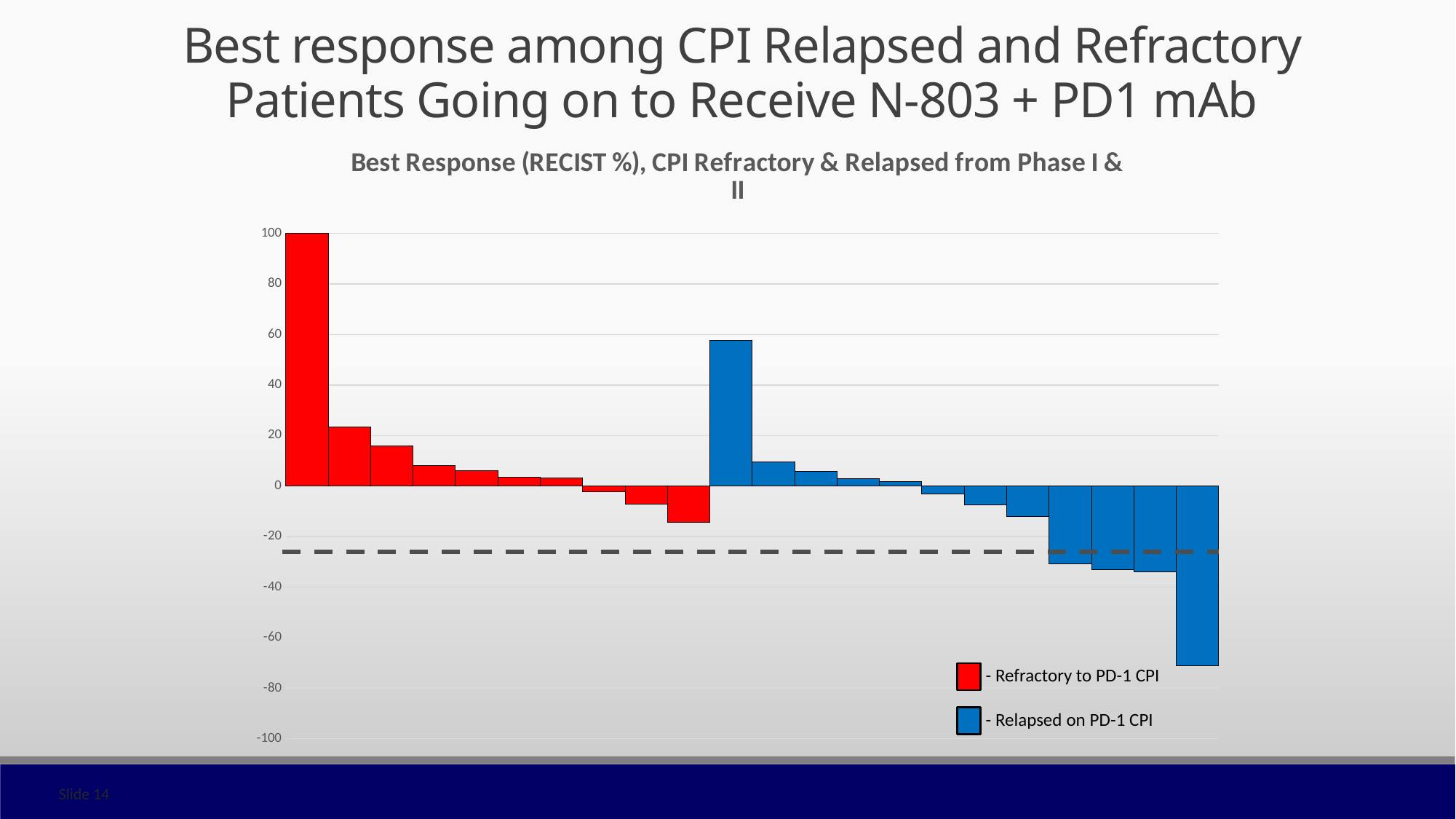
Which is larger: the tallest red bar or the tallest blue bar? The tallest red bar What are the two legend entries in the chart? Refractory to PD-1 CPI; Relapsed on PD-1 CPI How many series does the legend list? 2 Within each colour group, do the bar values rise or fall from left to right? Fall Is the value of the lowest blue (Relapsed on PD-1 CPI) bar greater or less than -60? less Is the value of the tallest blue (Relapsed on PD-1 CPI) bar greater or less than 40? greater Which series contains the single highest bar in the chart? Refractory to PD-1 CPI How many red (Refractory to PD-1 CPI) bars are plotted? 10 What kind of chart is shown on the slide? Bar chart Is the value of the tallest red (Refractory to PD-1 CPI) bar greater or less than 80? greater Which series contains the single lowest bar in the chart? Relapsed on PD-1 CPI What colour represents patients refractory to PD-1 CPI? Red